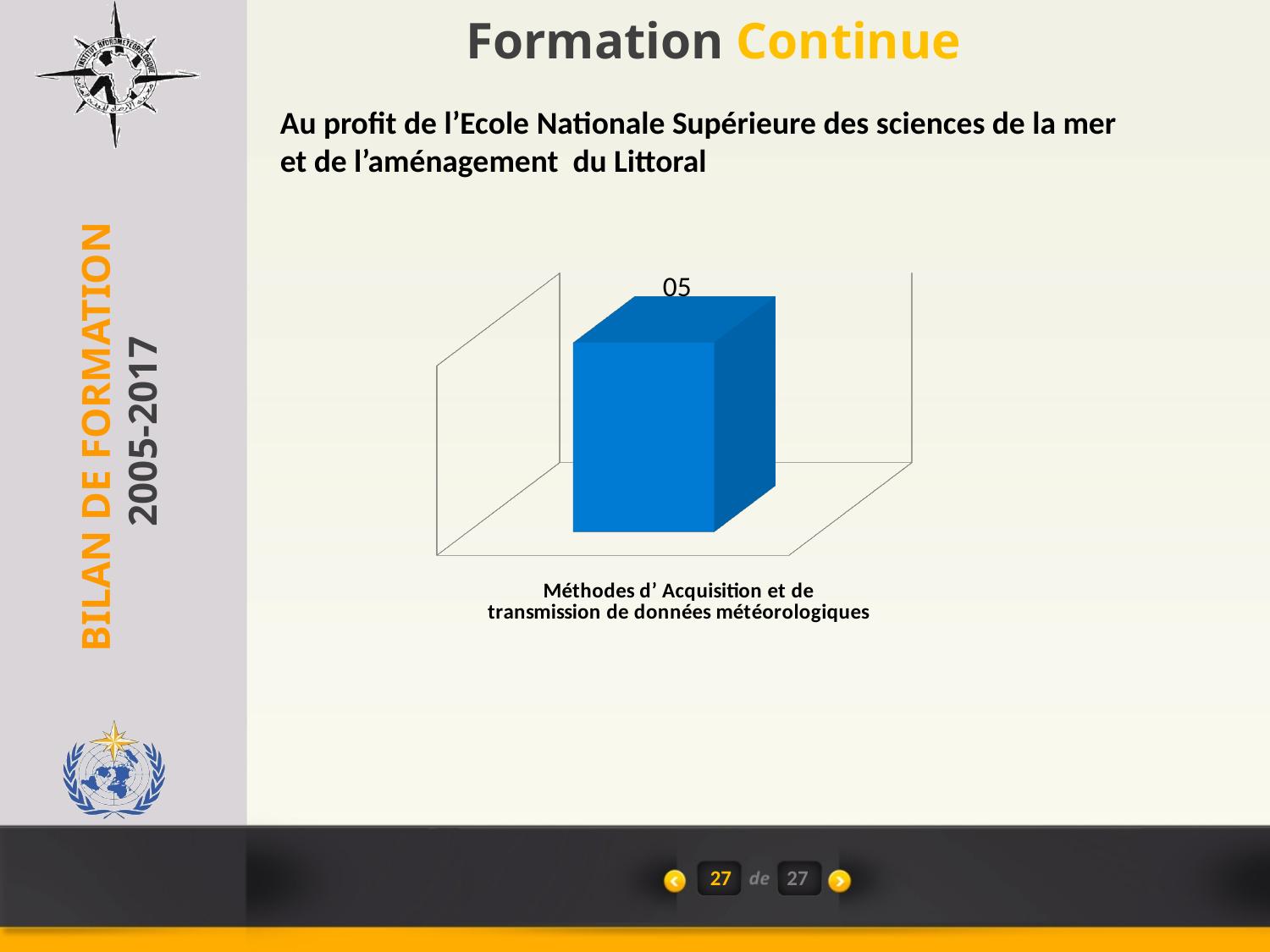
How many bars are plotted in the chart? 1 What is the label of the category shown under the bar? Méthodes d'Acquisition et de transmission de données météorologiques What value is shown for "Méthodes d'Acquisition et de transmission de données météorologiques"? 05 What kind of chart is shown on the slide? bar chart What colour is the bar in the chart? blue